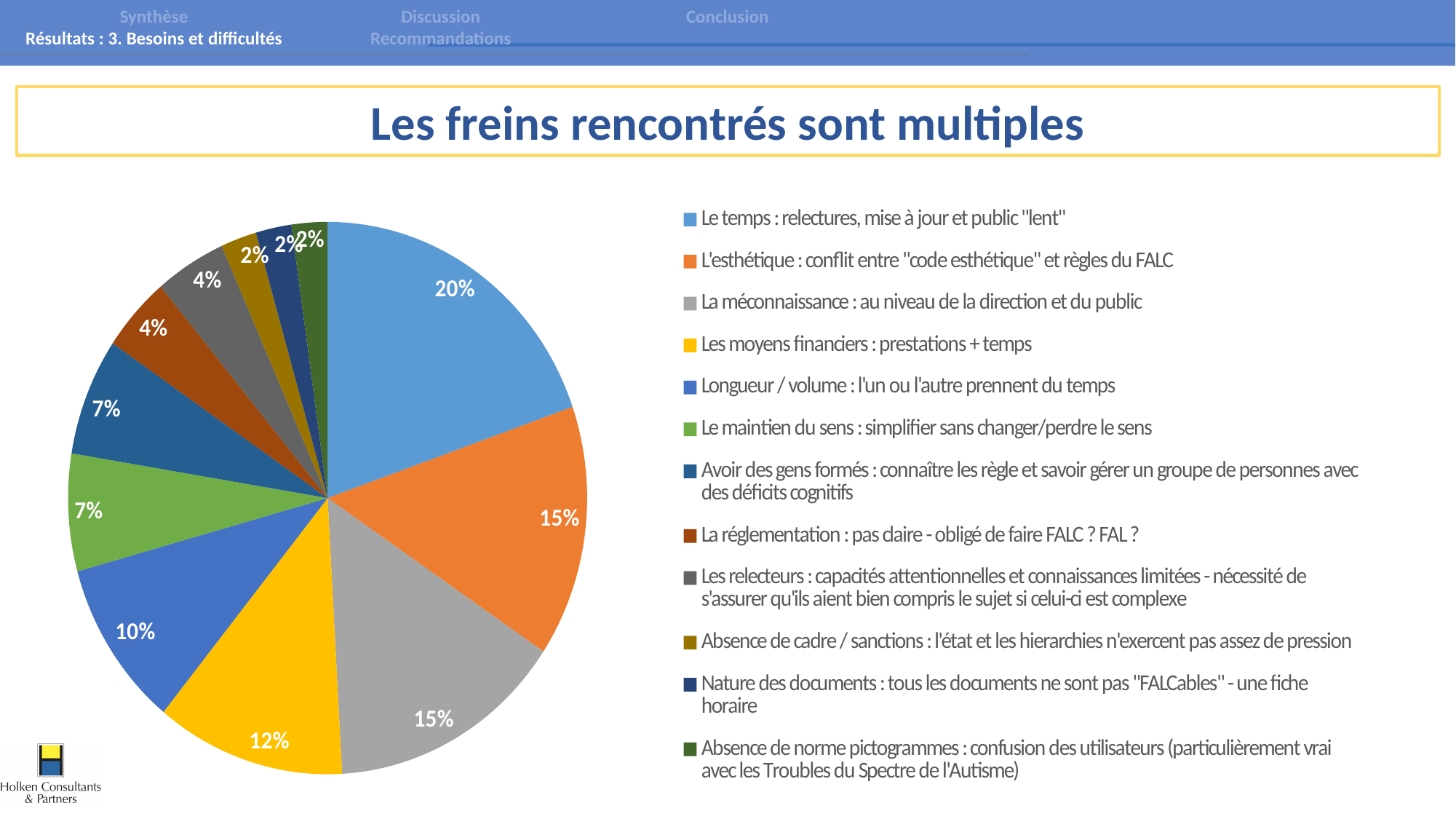
What share of the pie does "Le maintien du sens : simplifier sans changer/perdre le sens" represent? 7% How many slices does the pie chart have? 12 What percentage is shown for "Longueur / volume : l'un ou l'autre prennent du temps"? 10% Which is larger: the slice for "Le temps" or the slice for "L'esthétique"? Le temps What kind of chart is shown on the slide? pie chart What percentage is shown for "Les moyens financiers : prestations + temps"? 12% What is the difference in percentage points between the "Le temps" slice (20%) and the "Les moyens financiers" slice (12%)? 8 percentage points What is the title of the slide containing the pie chart? Les freins rencontrés sont multiples What percentage is shown for "La réglementation : pas claire - obligé de faire FALC ? FAL ?"? 4% How many entries does the legend list? 12 What percentage is shown for the slice "Le temps : relectures, mise à jour et public 'lent'"? 20% Which category has the largest slice of the pie? Le temps : relectures, mise à jour et public "lent"